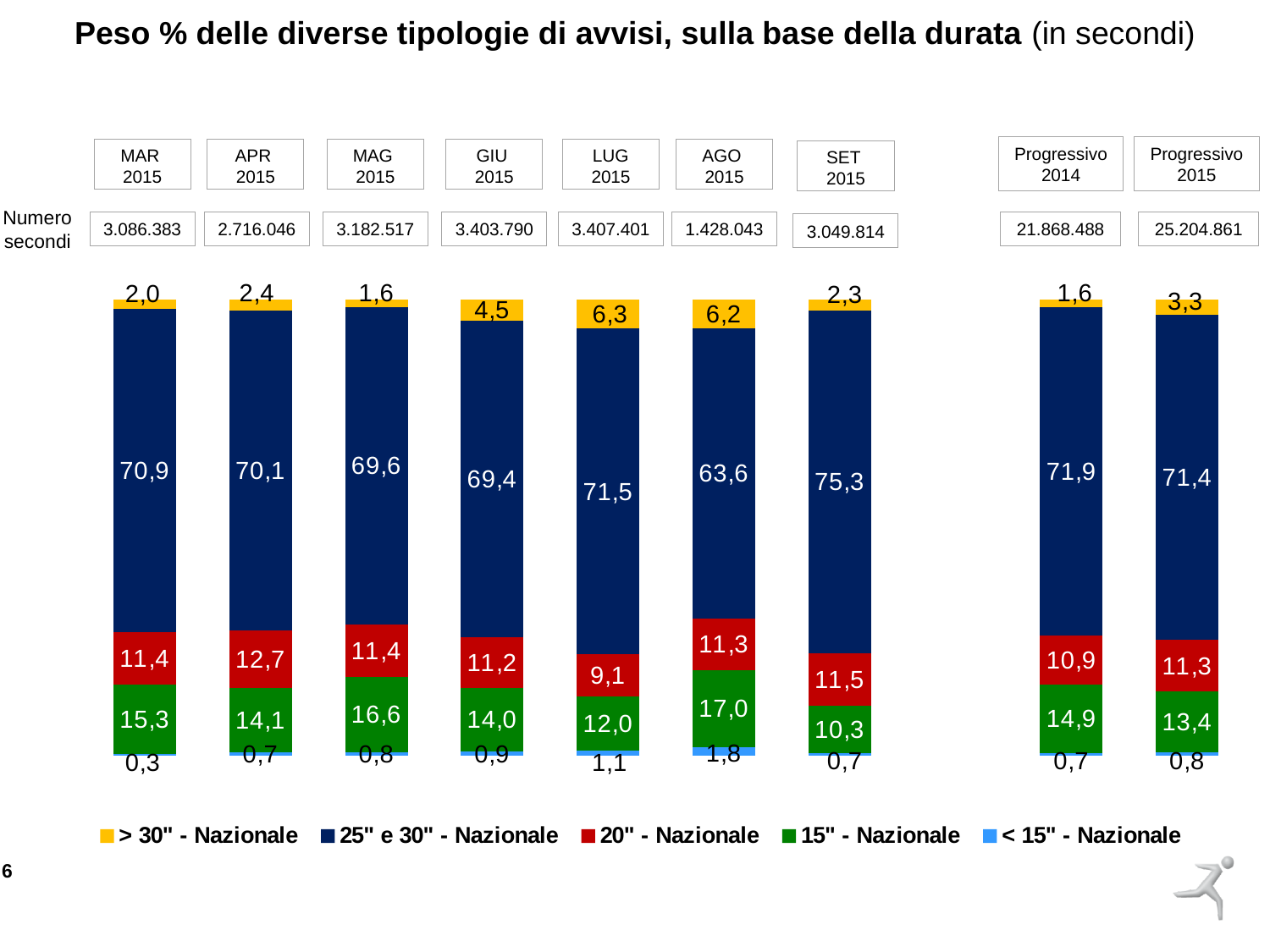
How many bars are plotted in the chart? 9 What is the difference between the "25" e 30" - Nazionale" values for SET 2015 and AGO 2015? 11,7 Which bar has the highest value for the "25" e 30" - Nazionale" segment? SET 2015 How many series does the legend list? 5 Which is larger, the "15" - Nazionale" value for MAG 2015 or for APR 2015? MAG 2015 Which bar has the lowest value for the "< 15" - Nazionale" segment? MAR 2015 What colour represents the "20" - Nazionale" series in the chart? Red What is the value of the "> 30" - Nazionale" segment for Progressivo 2015? 3,3 What is the value of the "20" - Nazionale" segment for APR 2015? 12,7 What is the value of the "15" - Nazionale" segment for AGO 2015? 17,0 What is the value of the "25" e 30" - Nazionale" segment for SET 2015? 75,3 What kind of chart is shown on the slide? Stacked bar chart